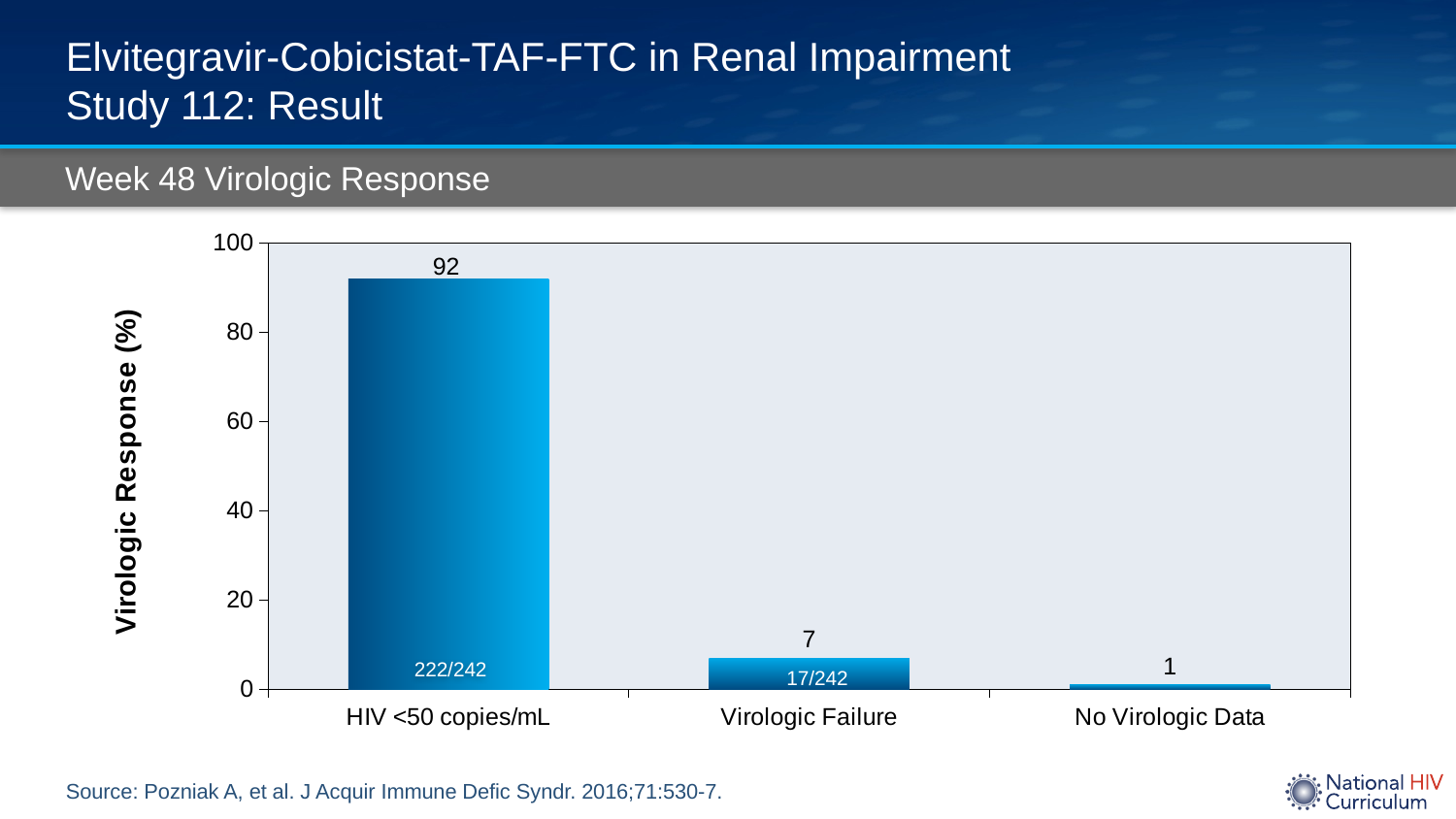
What kind of chart is shown on the slide? Bar chart Which category has the lowest value? No Virologic Data What is the virologic response (%) for Virologic Failure? 7 Is the value for HIV <50 copies/mL greater or less than 80? greater What is the difference in percentage points between HIV <50 copies/mL and Virologic Failure? 85 Which is larger, the value for Virologic Failure or the value for No Virologic Data? Virologic Failure What fraction is printed inside the HIV <50 copies/mL bar? 222/242 How many categories are shown on the x axis? 3 Which category has the highest value? HIV <50 copies/mL What is the virologic response (%) for HIV <50 copies/mL? 92 What is the label of the y axis? Virologic Response (%) What is the virologic response (%) for No Virologic Data? 1